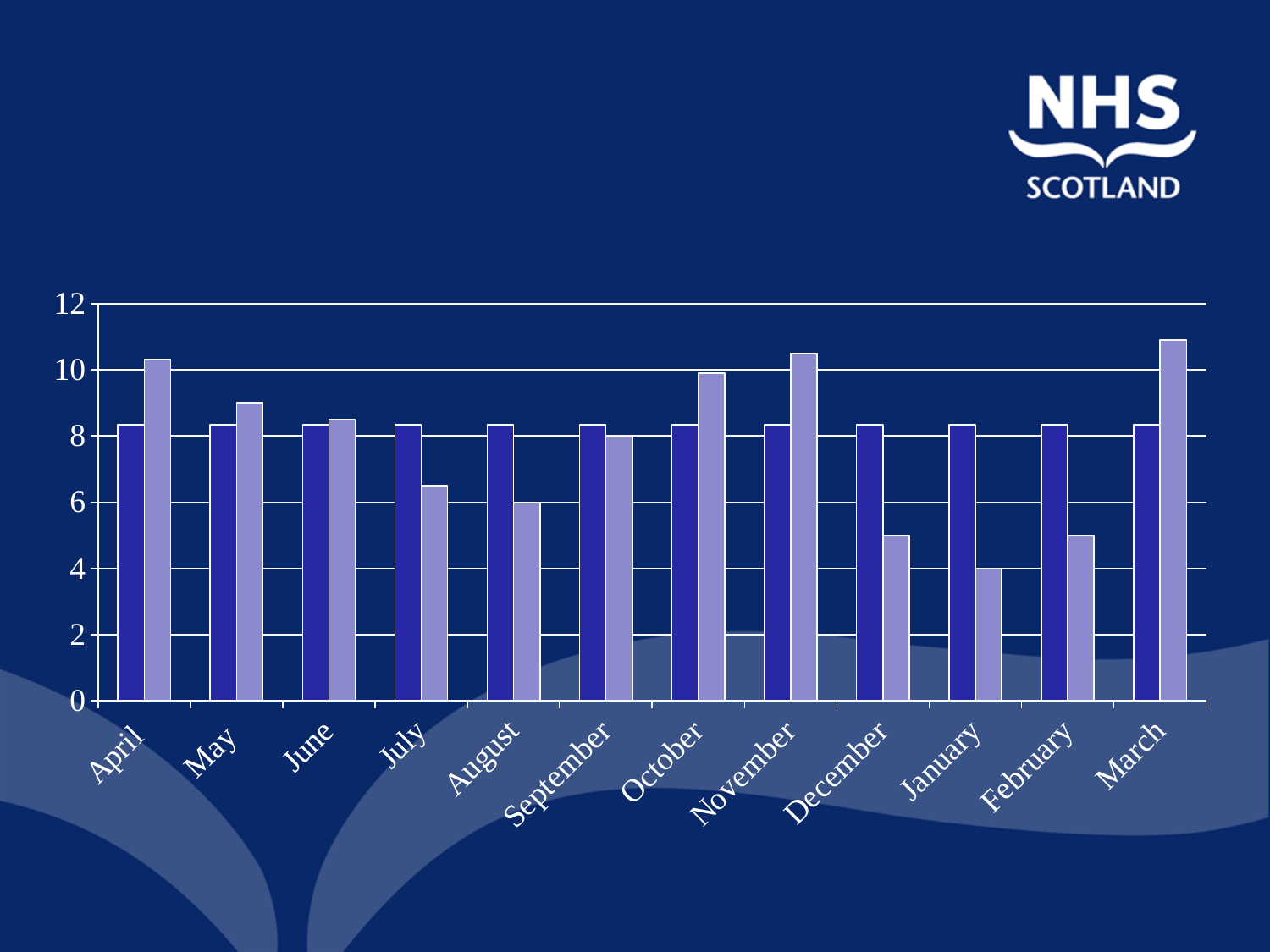
Do the lighter purple bars rise or fall from November to January? fall Is the lighter purple bar for March greater or less than 10? greater What is the highest value shown on the y axis of the chart? 12 Which month has the lowest lighter purple bar? January What kind of chart is shown on the slide? bar chart How many months are shown along the x axis of the chart? 12 Is the lighter purple bar for December greater or less than 4? greater Is the lighter purple bar for August greater or less than 8? less Which is larger, the lighter purple bar for April or the lighter purple bar for May? April Which month has the highest lighter purple bar? March